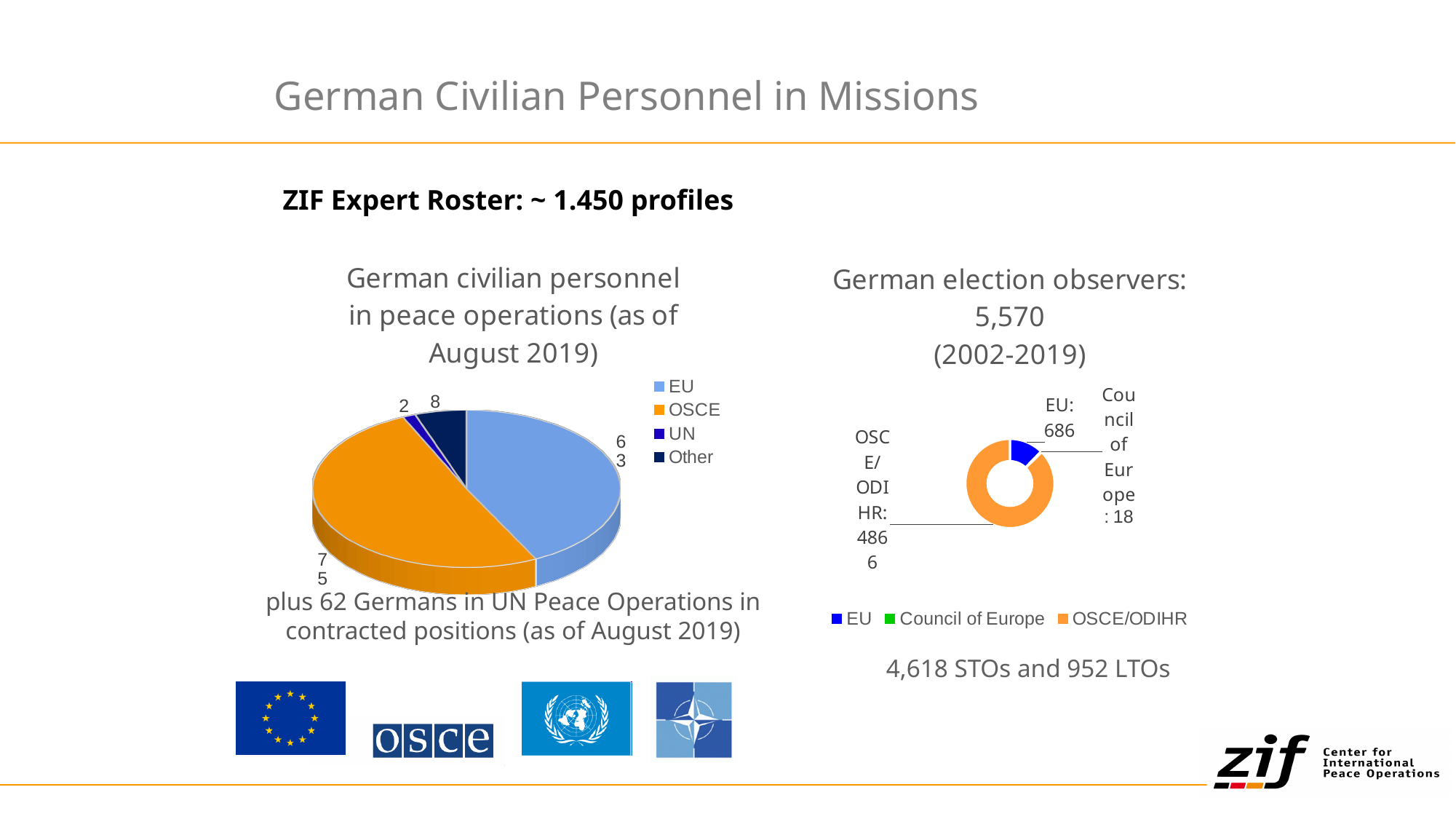
In the 'German civilian personnel in peace operations (as of August 2019)' chart, which category has the largest value? OSCE In the 'German election observers: 5,570 (2002-2019)' chart, what is the value for Council of Europe? 18 In the 'German civilian personnel in peace operations (as of August 2019)' chart, which category has the smallest value? UN In the 'German civilian personnel in peace operations (as of August 2019)' chart, how many categories does the legend list? 4 In the 'German election observers: 5,570 (2002-2019)' chart, what is the difference between the EU and Council of Europe values? 668 In the 'German election observers: 5,570 (2002-2019)' chart, which is larger, EU or Council of Europe? EU In the 'German election observers: 5,570 (2002-2019)' chart, what is the value for OSCE/ODIHR? 4866 In the 'German civilian personnel in peace operations (as of August 2019)' chart, what is the difference between the OSCE and EU values? 12 In the 'German civilian personnel in peace operations (as of August 2019)' chart, what is the value for OSCE? 75 What type of chart is the 'German civilian personnel in peace operations (as of August 2019)' chart? Pie chart In the 'German election observers: 5,570 (2002-2019)' chart, what colour represents OSCE/ODIHR? Orange In the 'German civilian personnel in peace operations (as of August 2019)' chart, what is the value for EU? 63